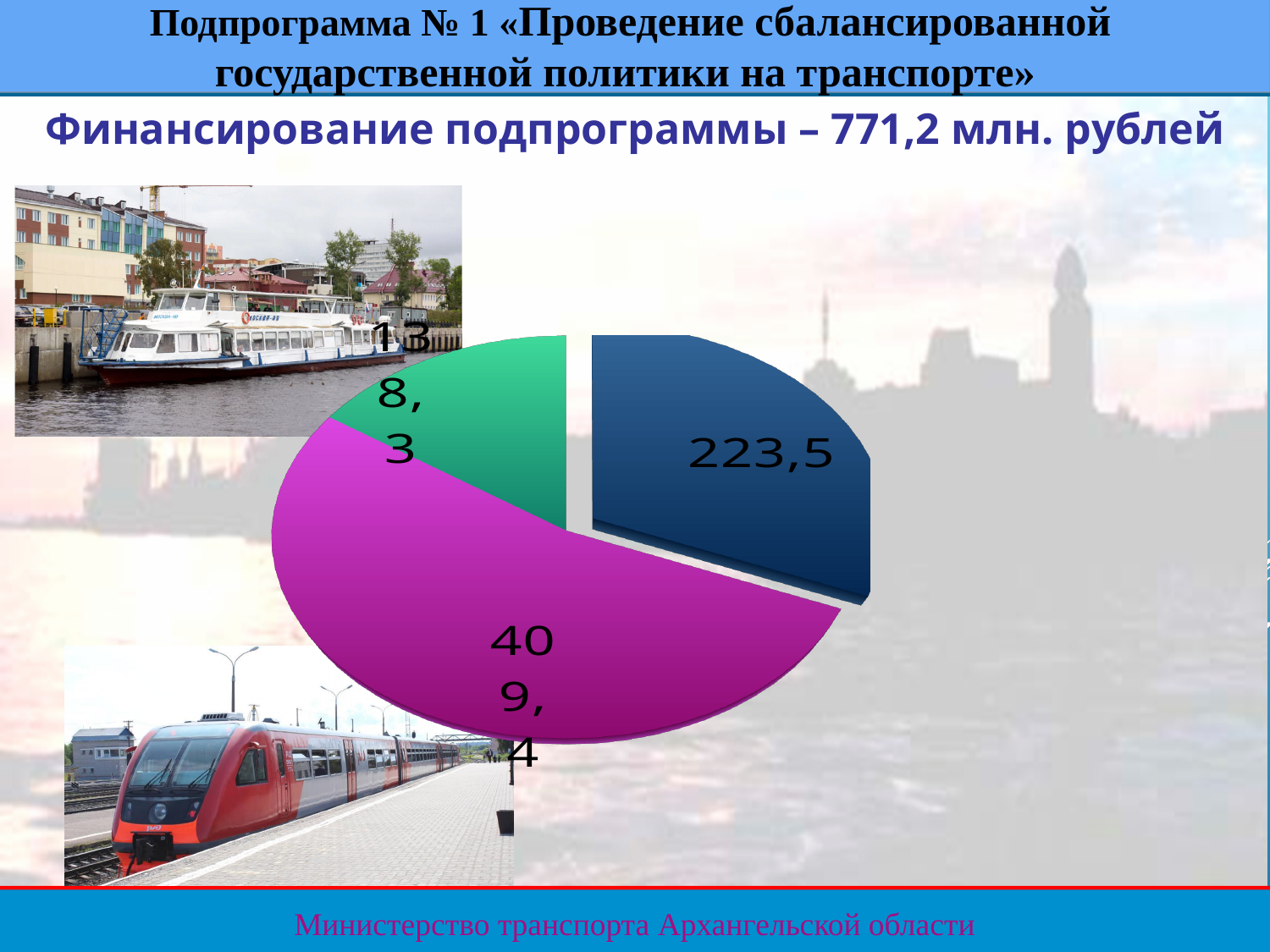
What total funding amount for the subprogramme is stated above the chart? 771,2 млн. рублей What is the difference between the magenta slice (409,4) and the blue slice (223,5)? 185,9 What type of chart is shown on the slide? pie chart Which slice of the pie chart has the smallest value? the green slice (138,3) What is the total of all three slices of the pie chart? 771,2 Which is larger, the blue slice or the green slice? the blue slice What value is shown on the blue slice of the pie chart? 223,5 What value is shown on the magenta slice of the pie chart? 409,4 What is the difference between the blue slice (223,5) and the green slice (138,3)? 85,2 How many slices does the pie chart have? 3 Which slice of the pie chart has the largest value? the magenta slice (409,4) What value is shown on the green slice of the pie chart? 138,3